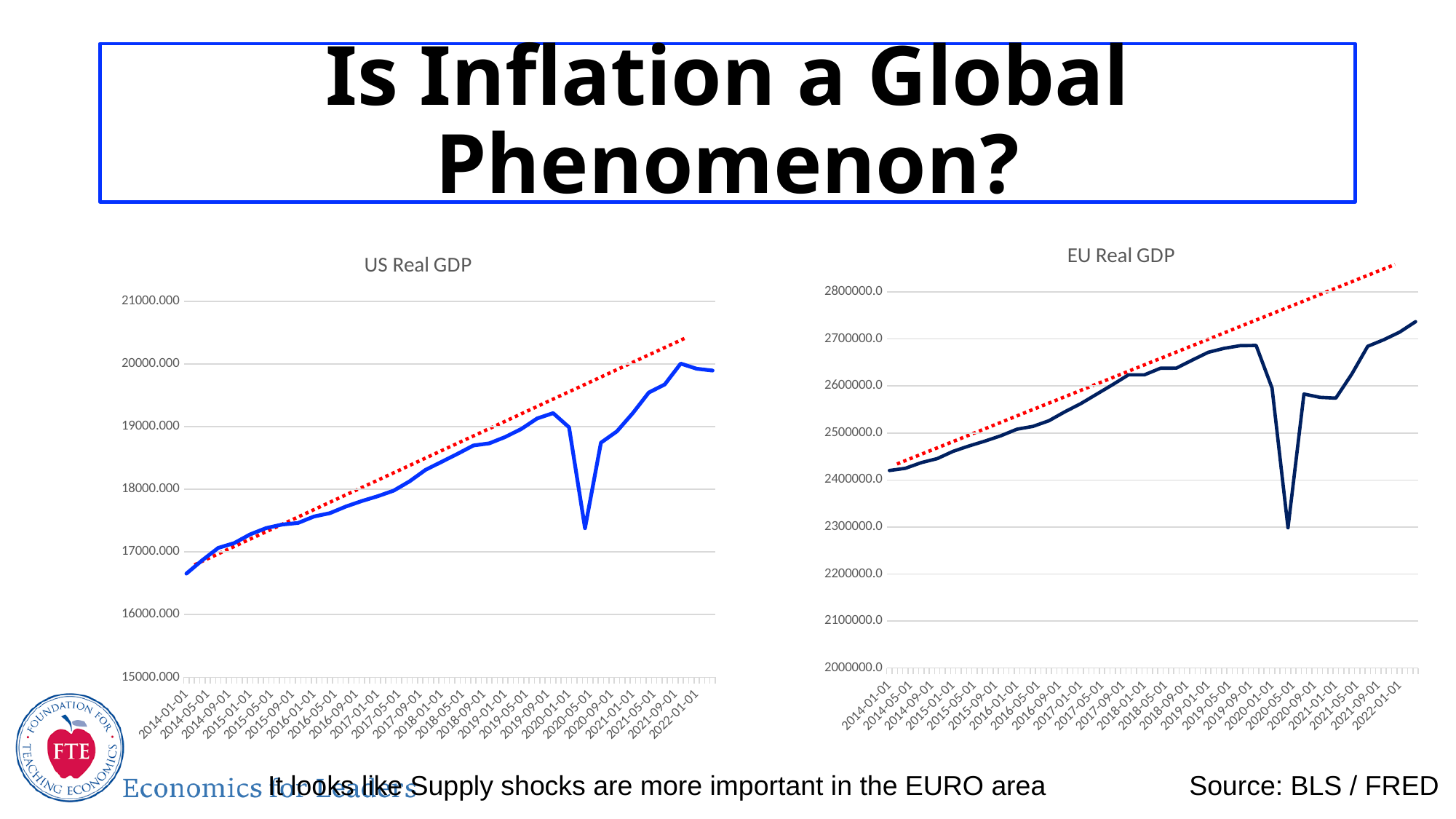
In the US Real GDP chart, which is larger, the value at 2014-01-01 or the value at 2022-01-01? 2022-01-01 In the EU Real GDP chart, do the values generally rise or fall from 2014-01-01 to 2022-01-01? rise In the US Real GDP chart, is the value at 2014-01-01 greater or less than 17000.000? less In the US Real GDP chart, is the value at 2022-01-01 greater or less than 19000.000? greater In the EU Real GDP chart, is the value at 2022-01-01 greater or less than 2700000.0? greater What is the title of the chart on the right side of the slide? EU Real GDP What kind of chart is the EU Real GDP chart? line chart What kind of chart is the US Real GDP chart? line chart In the US Real GDP chart, do the values generally rise or fall from 2014-01-01 to 2022-01-01? rise